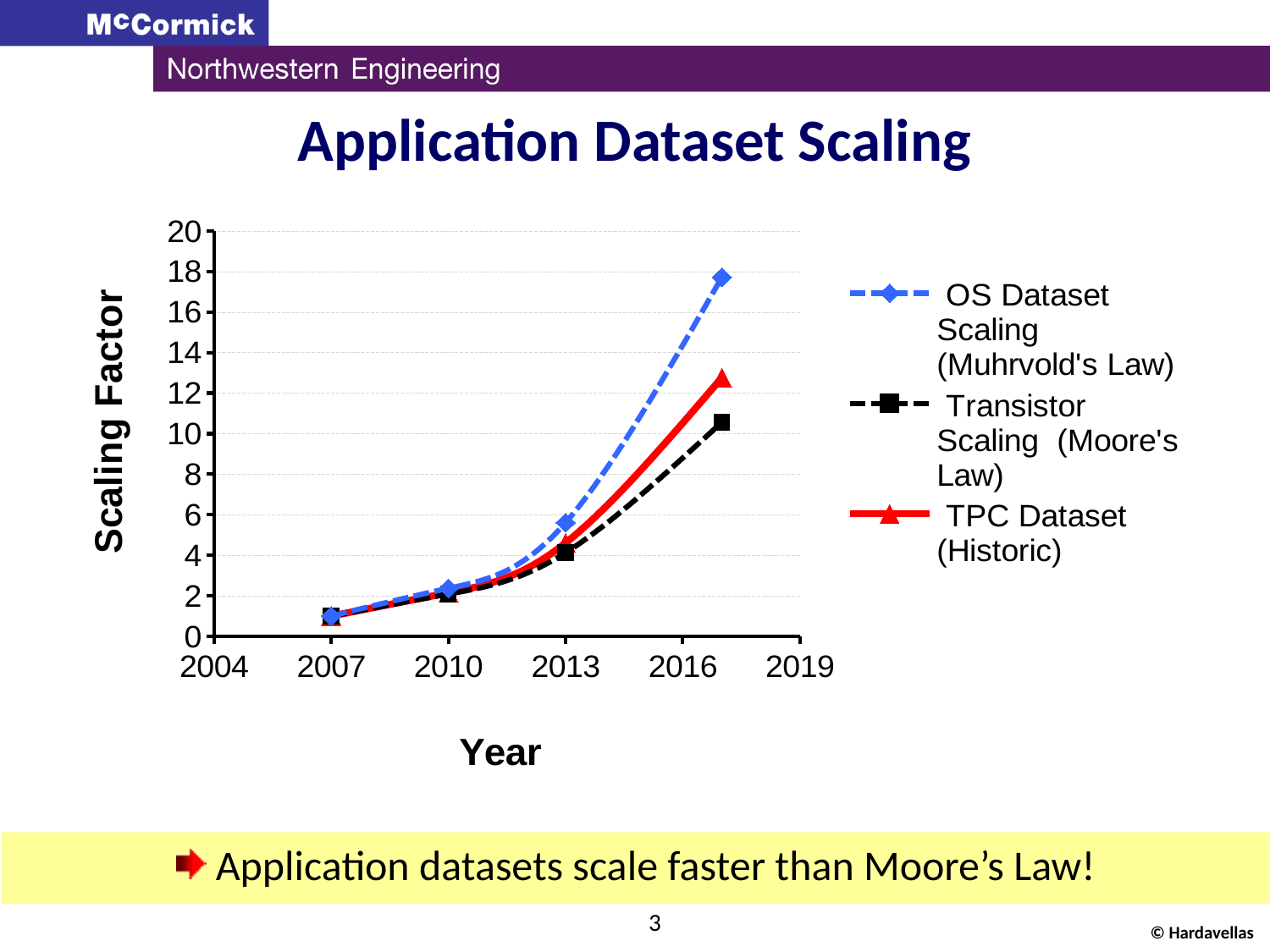
What kind of chart is shown on the slide? line chart Is the value for Transistor Scaling (Moore's Law) at 2017 greater or less than 12? less Which series has the lowest scaling factor at the final (2017) data point? Transistor Scaling (Moore's Law) How many series does the legend list? 3 What is the title of the chart's y axis? Scaling Factor How many data points are plotted for the OS Dataset Scaling (Muhrvold's Law) series? 4 Do the scaling factor values rise or fall as the year increases? rise At the 2017 data point, which is larger: OS Dataset Scaling or Transistor Scaling? OS Dataset Scaling Is the value for Transistor Scaling (Moore's Law) at 2013 greater or less than 6? less Is the value for TPC Dataset (Historic) at 2017 greater or less than 10? greater Which series has the highest scaling factor at the final (2017) data point? OS Dataset Scaling (Muhrvold's Law)